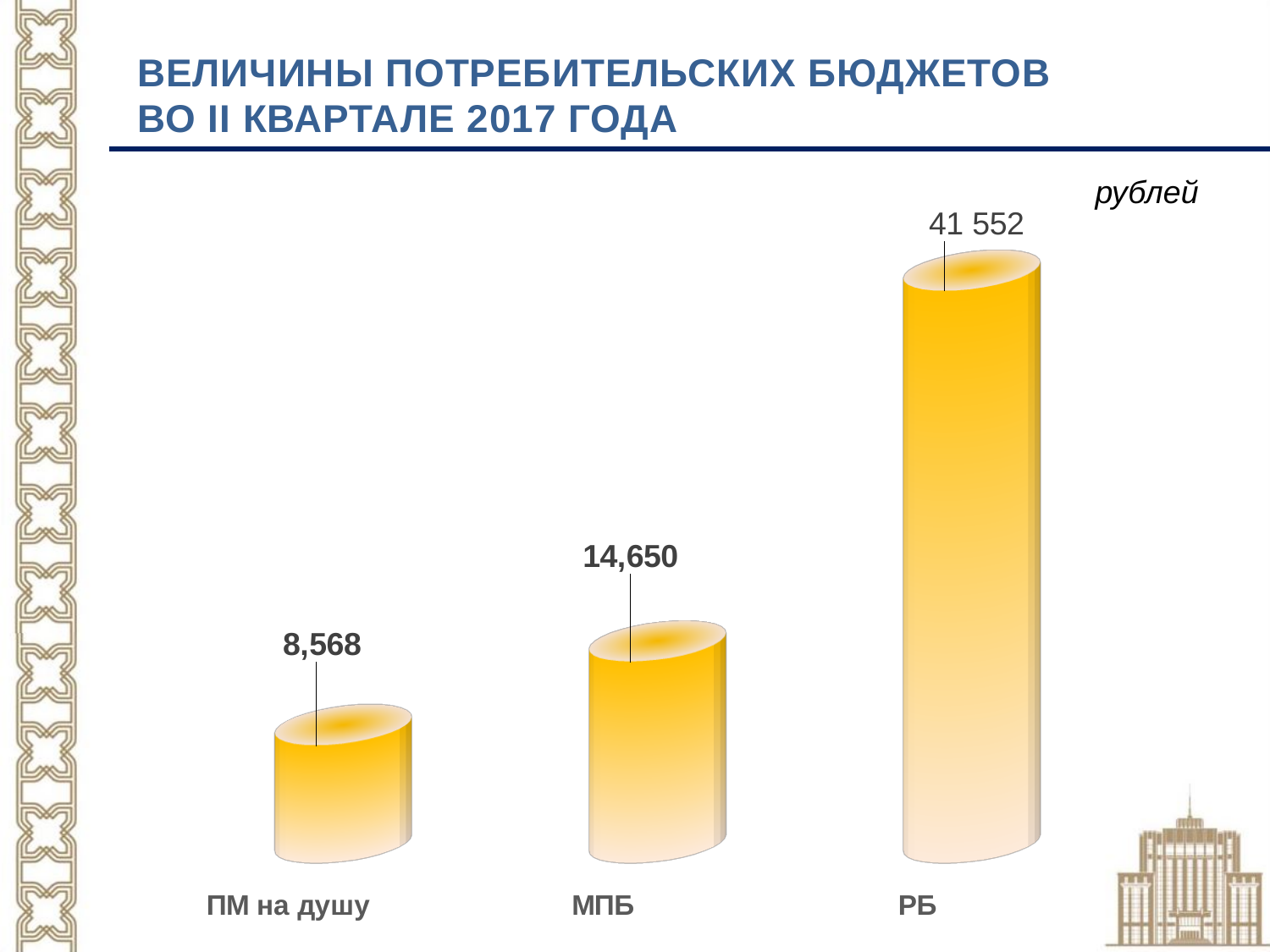
What is the difference between the values for МПБ and ПМ на душу? 6,082 What is the value for МПБ? 14,650 How many categories are shown in the chart? 3 What kind of chart is shown on the slide? Bar chart What is the difference between the values for РБ and МПБ? 26,902 Which is larger, the value for МПБ or the value for ПМ на душу? МПБ What is the value for РБ? 41 552 What is the value for ПМ на душу? 8,568 Which category has the lowest value? ПМ на душу Which category has the highest value? РБ In what unit are the chart values given, according to the label at the top right of the chart? рублей Do the values rise or fall from left to right across the categories? Rise